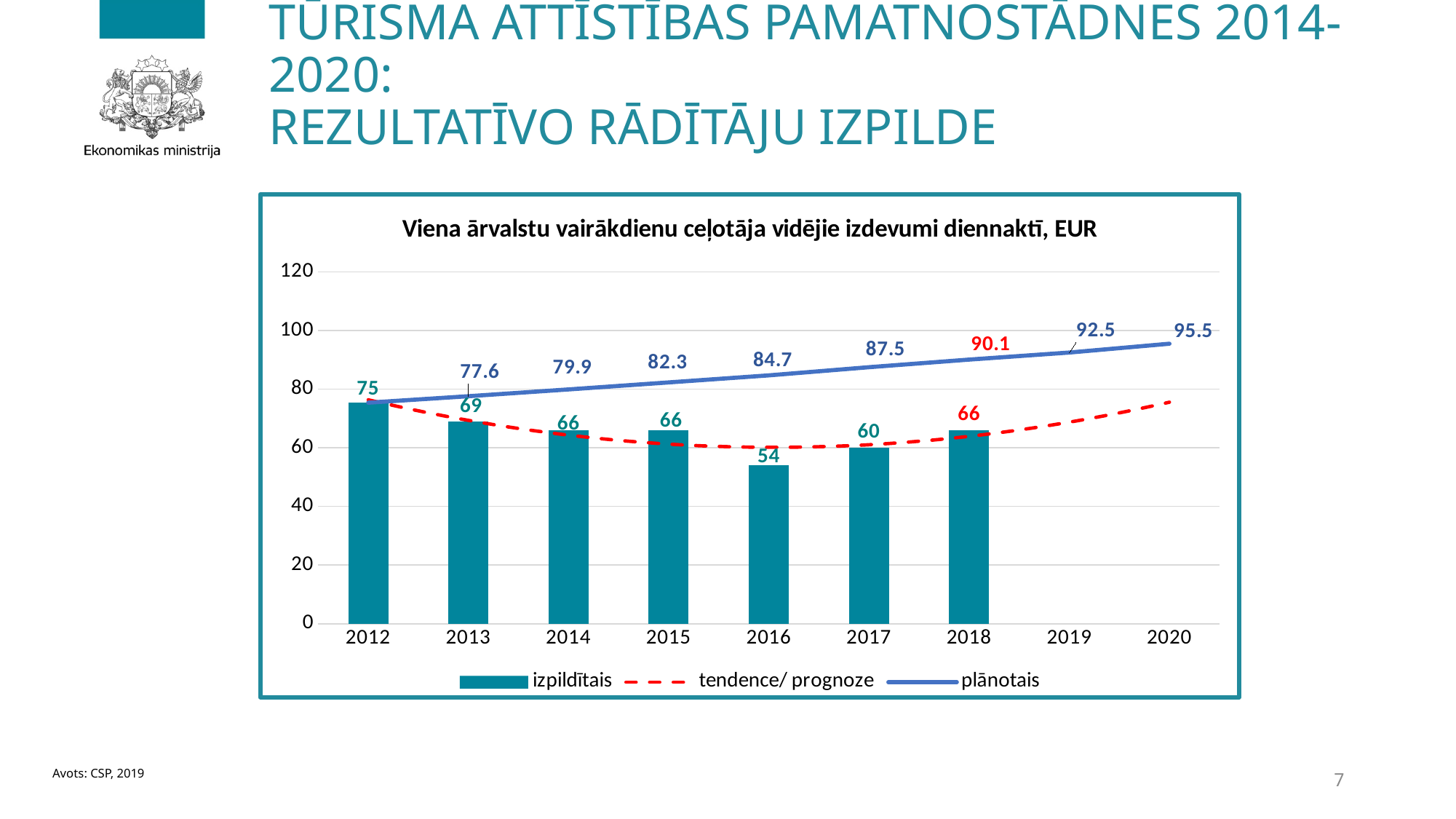
Which year has the highest izpildītais bar? 2012 Is the plānotais value for 2019 greater or less than 80? greater Does the plānotais line rise or fall from 2012 to 2020? rises How many years have an izpildītais bar? 7 What is the title of the chart? Viena ārvalstu vairākdienu ceļotāja vidējie izdevumi diennaktī, EUR Which year has the lowest izpildītais bar? 2016 Which is larger, the izpildītais value for 2013 or for 2017? 2013 What is the plānotais value for 2015? 82.3 How many series does the legend list? 3 What is the izpildītais value for 2016? 54 What is the plānotais value for 2020? 95.5 What is the difference between the plānotais value and the izpildītais value for 2018? 24.1